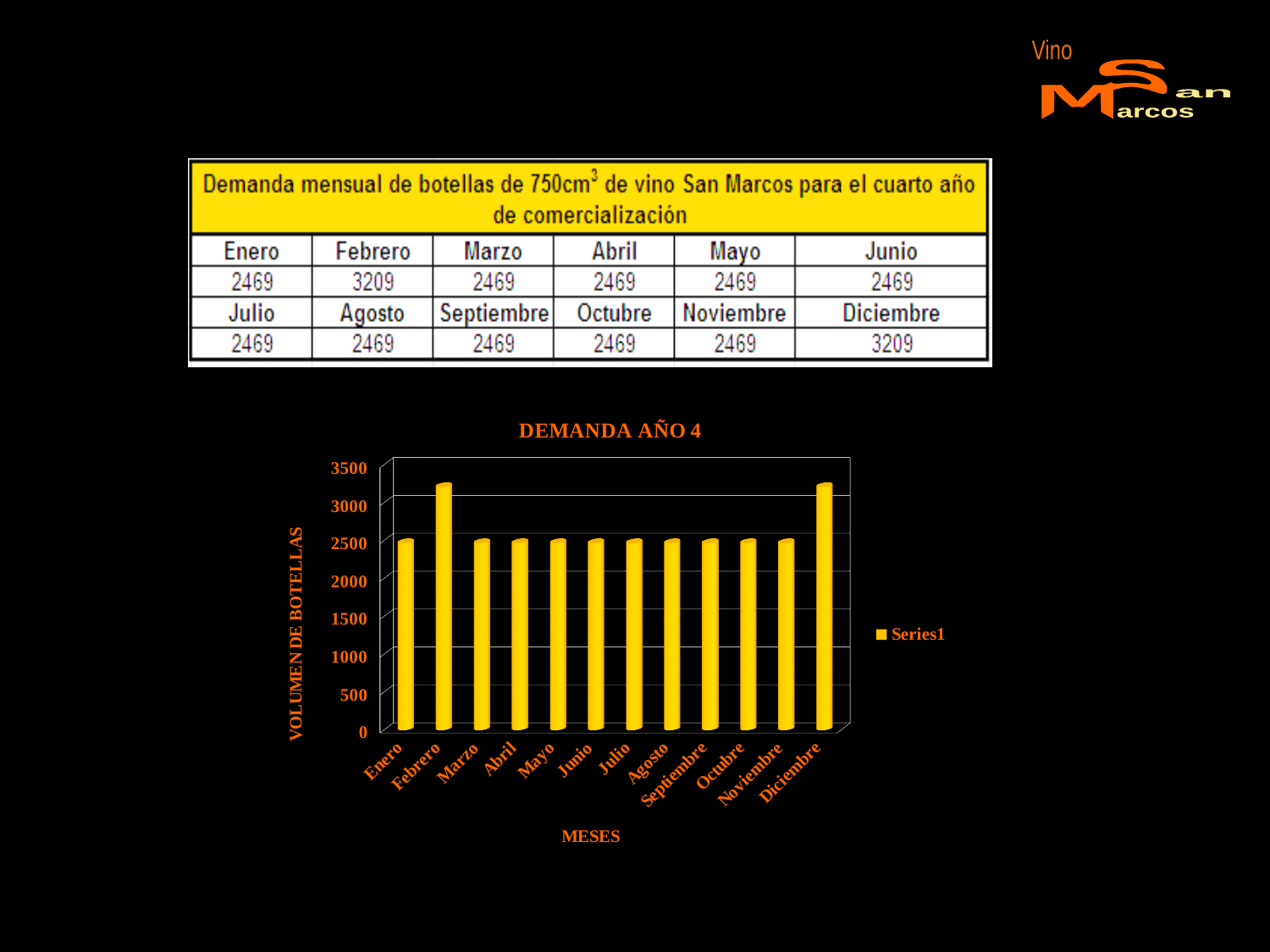
What is the value for Febrero in the DEMANDA AÑO 4 chart? 3209 How many months are shown on the x axis of the DEMANDA AÑO 4 chart? 12 What is the value for Diciembre in the DEMANDA AÑO 4 chart? 3209 Which months have the highest value in the DEMANDA AÑO 4 chart? Febrero and Diciembre Is the value for Diciembre in the DEMANDA AÑO 4 chart greater or less than 3000? greater What is the value for Julio in the DEMANDA AÑO 4 chart? 2469 What kind of chart is DEMANDA AÑO 4? bar chart How many series does the legend of the DEMANDA AÑO 4 chart list? 1 What is the difference between the values for Febrero and Enero in the DEMANDA AÑO 4 chart? 740 Is the value for Octubre in the DEMANDA AÑO 4 chart greater or less than 3000? less What is the label of the vertical axis in the DEMANDA AÑO 4 chart? VOLUMEN DE BOTELLAS Which is larger in the DEMANDA AÑO 4 chart, the value for Febrero or the value for Marzo? Febrero